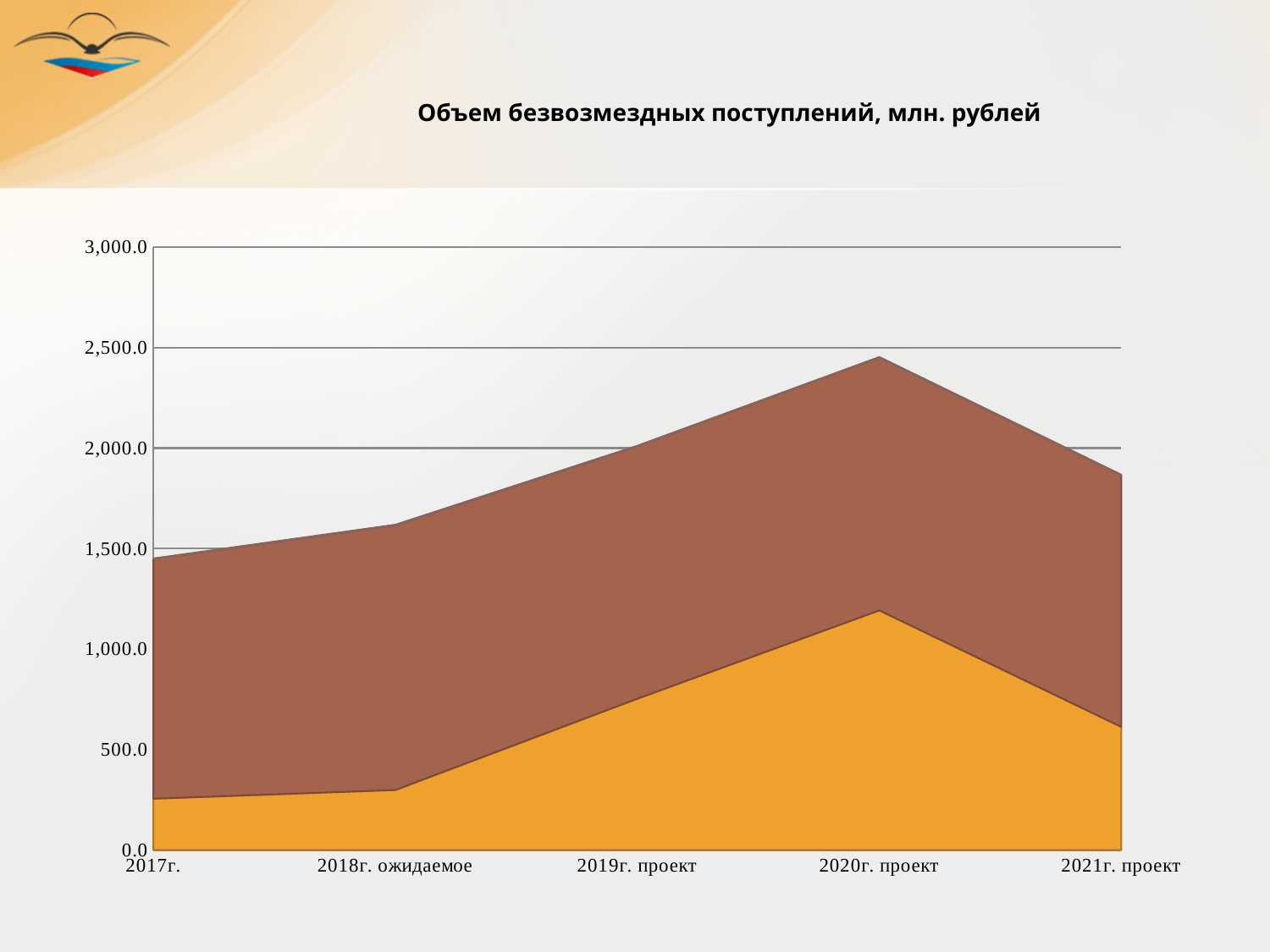
In which category does the total stacked area reach its highest point? 2020г. проект Is the total value for 2020г. проект greater or less than 2,000.0? greater Is the value of the orange (bottom) series for 2017г. greater or less than 500.0? less How many categories are shown along the x axis? 5 What kind of chart is shown on the slide? area chart Does the total stacked value rise or fall from 2017г. to 2020г. проект? rise What is the title of the chart? Объем безвозмездных поступлений, млн. рублей Is the total value for 2021г. проект greater or less than 2,000.0? less In which category is the total stacked area lowest? 2017г. In which category does the orange (bottom) series reach its highest value? 2020г. проект Which is larger for the orange (bottom) series: 2018г. ожидаемое or 2020г. проект? 2020г. проект